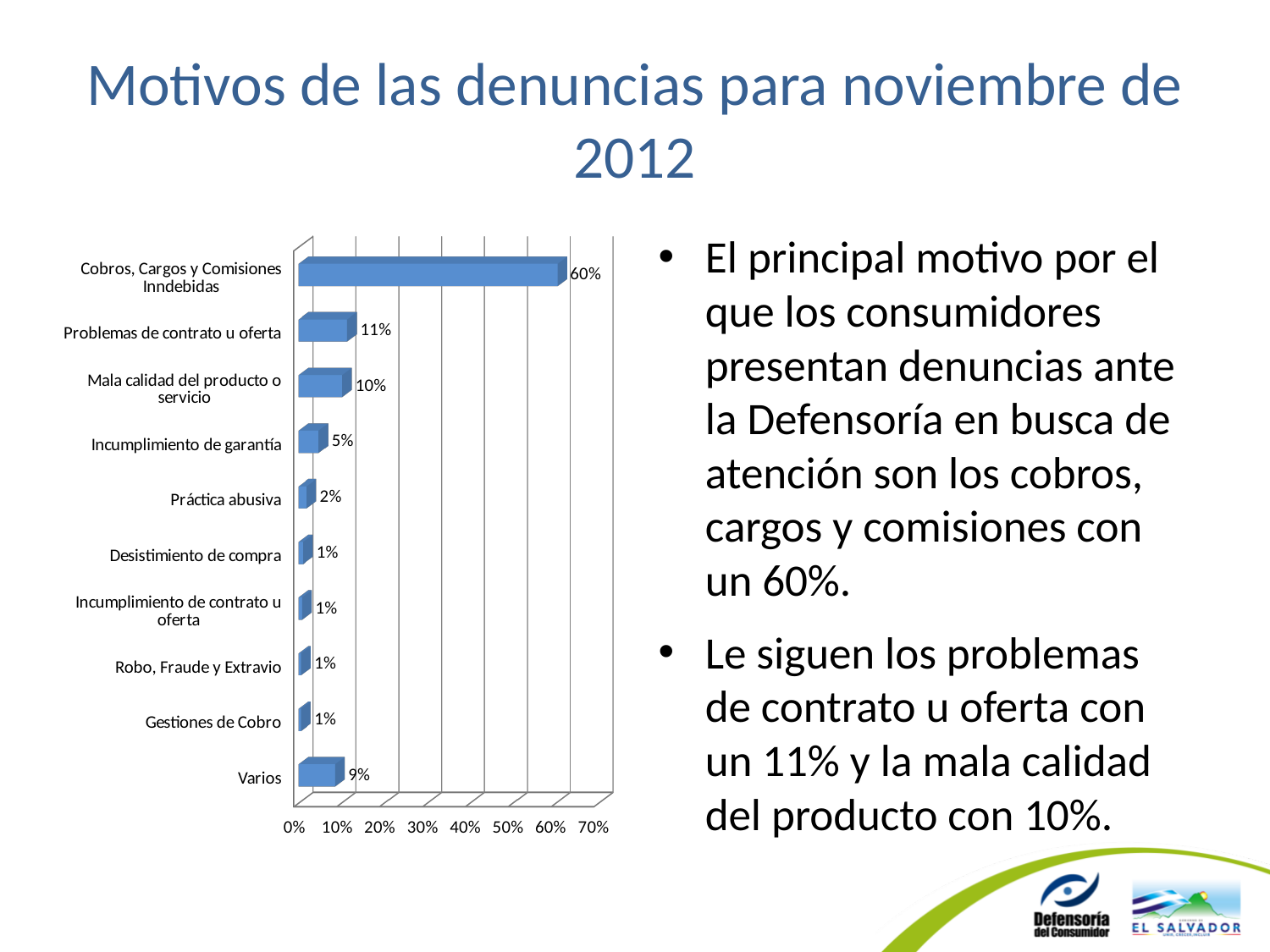
What is the value for Incumplimiento de garantía? 5% What is the title of the slide containing the chart? Motivos de las denuncias para noviembre de 2012 What kind of chart is shown on the slide? Bar chart How many categories are shown in the chart? 10 What is the value for Cobros, Cargos y Comisiones Inndebidas? 60% What is the value for Varios? 9% What is the difference between the values for Cobros, Cargos y Comisiones Inndebidas and Problemas de contrato u oferta? 49% What is the difference between the values for Mala calidad del producto o servicio and Práctica abusiva? 8% Which category has the highest value? Cobros, Cargos y Comisiones Inndebidas What is the value for Problemas de contrato u oferta? 11% Is the value for Cobros, Cargos y Comisiones Inndebidas greater or less than 50%? greater Which is larger, the value for Varios or the value for Incumplimiento de garantía? Varios